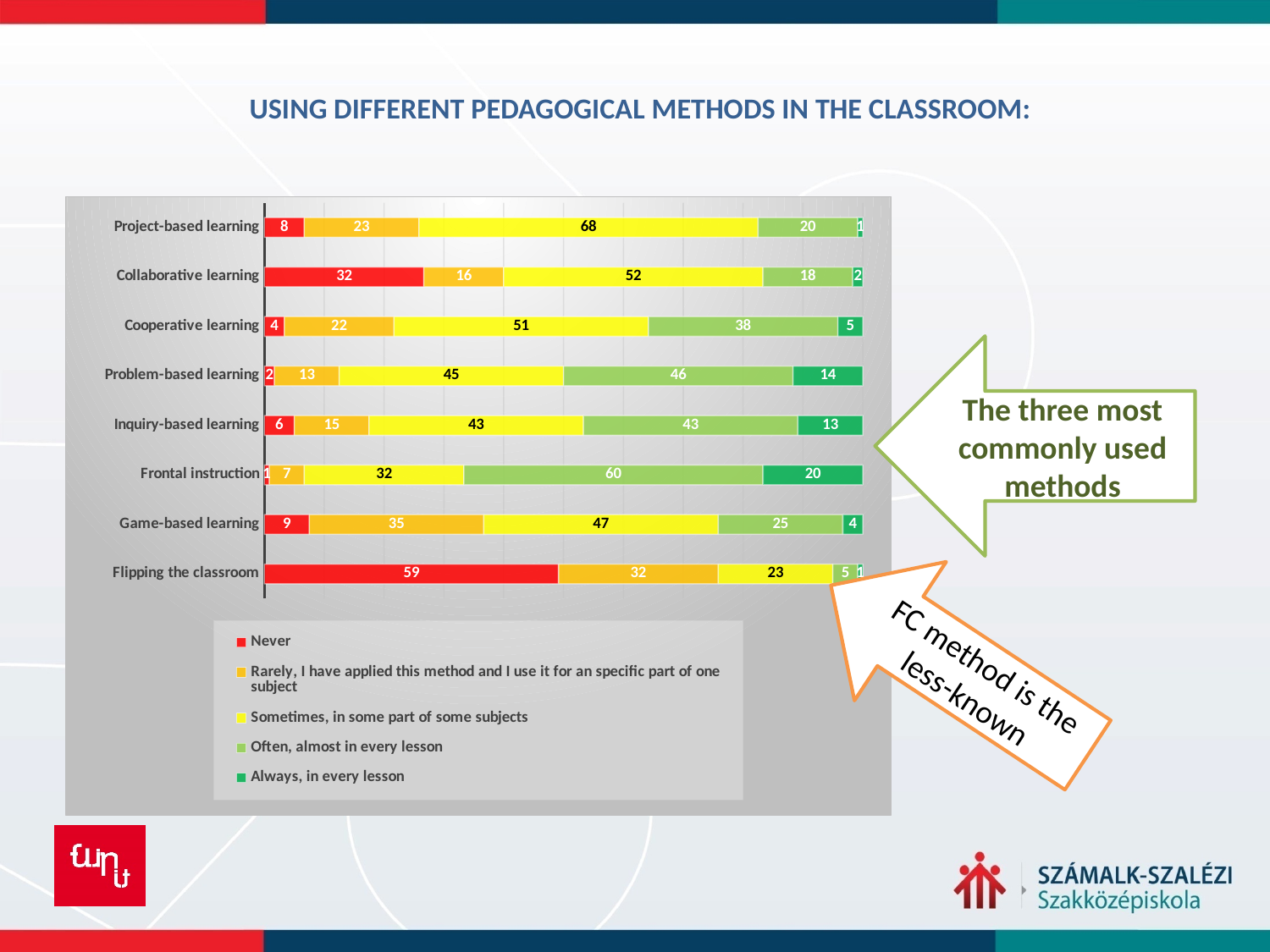
What kind of chart is shown on the slide? Stacked bar chart What is the total of the stacked bar for Game-based learning? 120 Which method has the lowest 'Never' value? Frontal instruction What is the difference between the 'Never' values for Flipping the classroom and Collaborative learning? 27 What is the 'Sometimes, in some part of some subjects' value for Project-based learning? 68 Which has a larger 'Always, in every lesson' value, Frontal instruction or Problem-based learning? Frontal instruction What colour represents the 'Never' series in the chart? Red How many series does the legend list? 5 What is the 'Often, almost in every lesson' value for Frontal instruction? 60 How many pedagogical methods (categories) are shown in the chart? 8 Which method has the highest 'Never' value? Flipping the classroom What is the 'Never' value for Flipping the classroom? 59